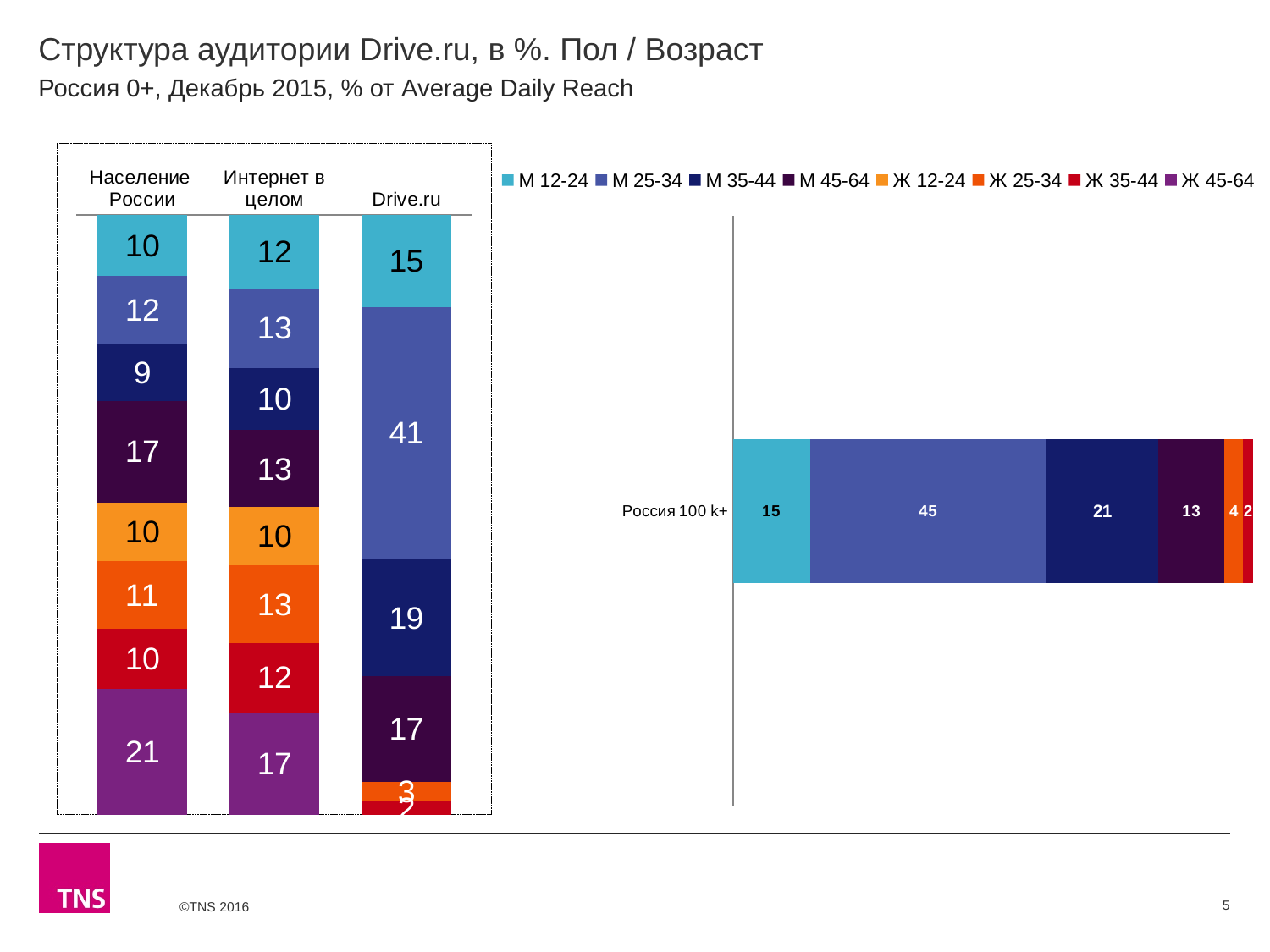
In the left chart, which group has the smallest value in the Население России column? М 35-44 What kind of chart is the left chart? Stacked bar chart In the right chart (Россия 100 k+), what is the value for М 35-44? 21 In the left chart, what is the difference between the М 25-34 value for Drive.ru and for Население России? 29 In the left chart, what is the value for Ж 45-64 in the Интернет в целом column? 17 In the right chart (Россия 100 k+), which group has the largest segment? М 25-34 In the left chart, what is the value for М 45-64 in the Население России column? 17 In the left chart, what is the value for М 25-34 in the Drive.ru column? 41 In the left chart, which is larger: the Ж 45-64 value for Население России or for Интернет в целом? Население России In the right chart (Россия 100 k+), what is the value for М 25-34? 45 How many series does the legend list? 8 In the left chart, which column has the largest М 25-34 segment? Drive.ru